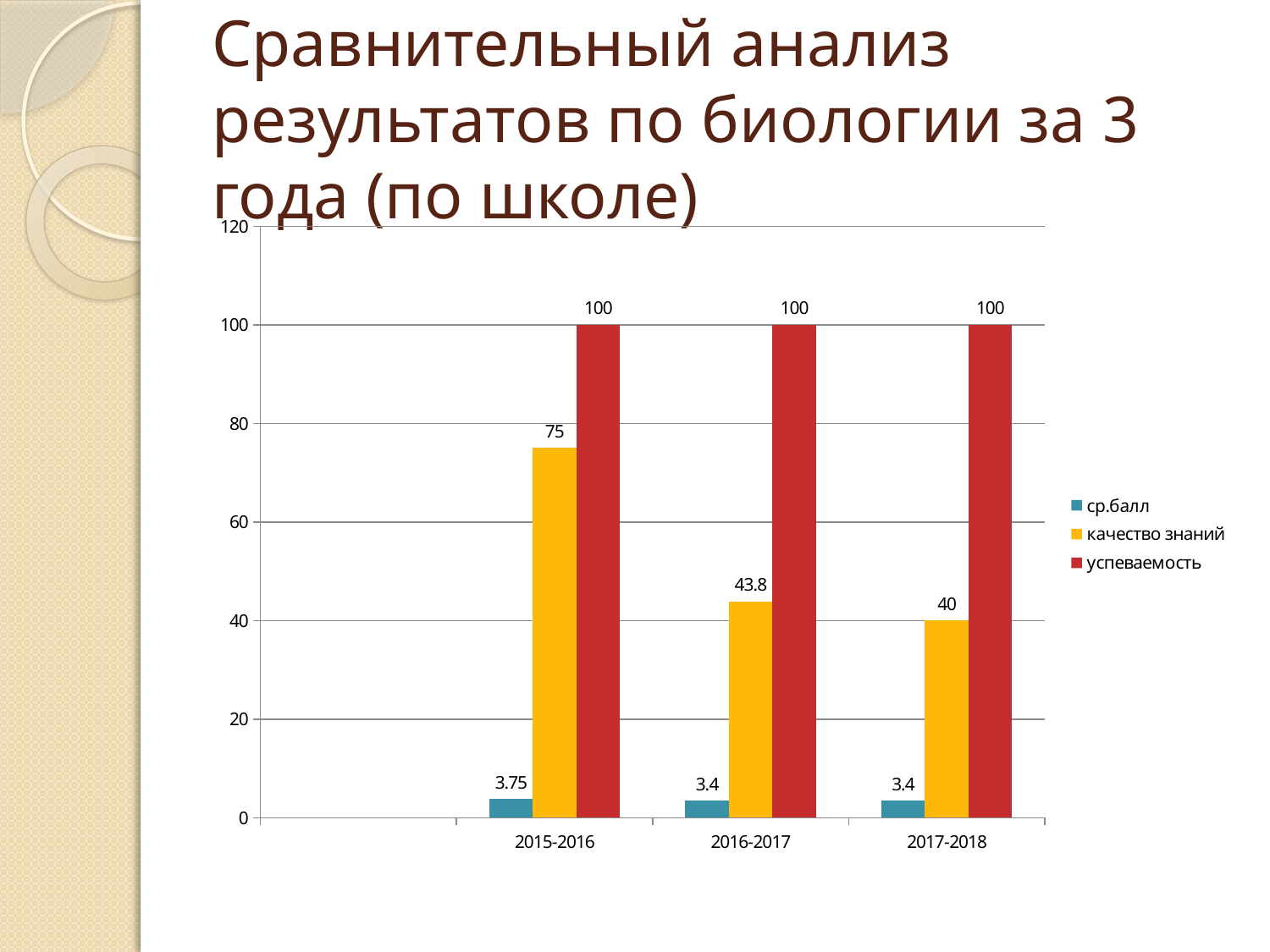
What is the value of качество знаний for 2016-2017? 43.8 What is the value of ср.балл for 2016-2017? 3.4 Which is larger: ср.балл in 2015-2016 or ср.балл in 2017-2018? 2015-2016 How many series does the legend list? 3 What is the difference between качество знаний in 2015-2016 and in 2017-2018? 35 Which year has the lowest value of качество знаний? 2017-2018 What is the value of качество знаний for 2015-2016? 75 Does the value of качество знаний rise or fall from 2015-2016 to 2017-2018? fall Which year has the highest value of качество знаний? 2015-2016 How many year categories are shown on the x axis? 3 What is the value of успеваемость for 2017-2018? 100 What kind of chart is shown on the slide? bar chart